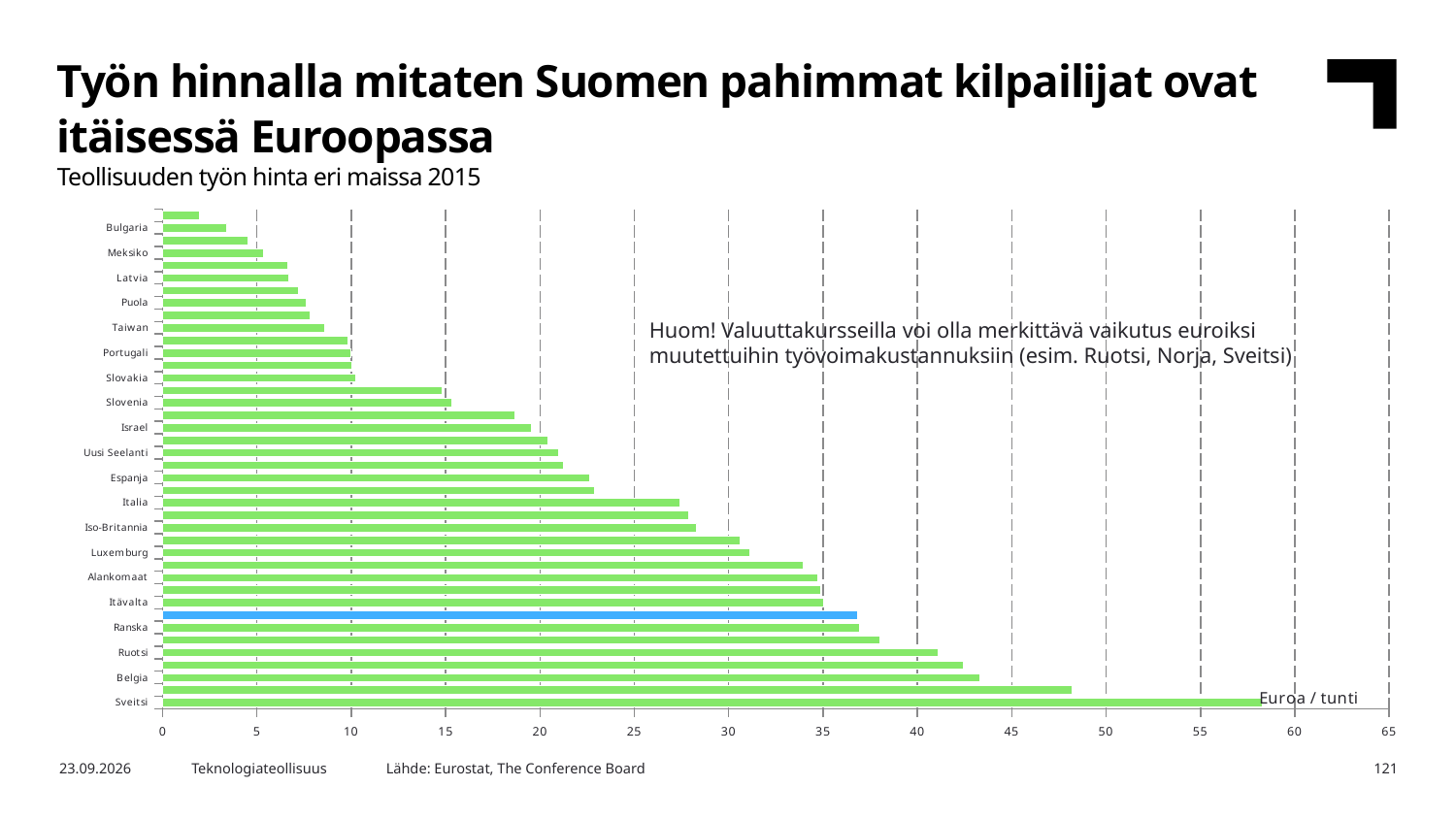
What unit is shown for the values on the chart? Euroa / tunti What kind of chart is shown on the slide? bar chart Is the value for Luxemburg greater or less than 35? less Is the value for Iso-Britannia greater or less than 30? less Which has a higher value, Sveitsi or Puola? Sveitsi Is the value for Taiwan greater or less than 10? less Which has a higher value, Latvia or Ruotsi? Ruotsi Which labelled country has the highest labour cost in the chart? Sveitsi What is the subtitle of the chart? Teollisuuden työn hinta eri maissa 2015